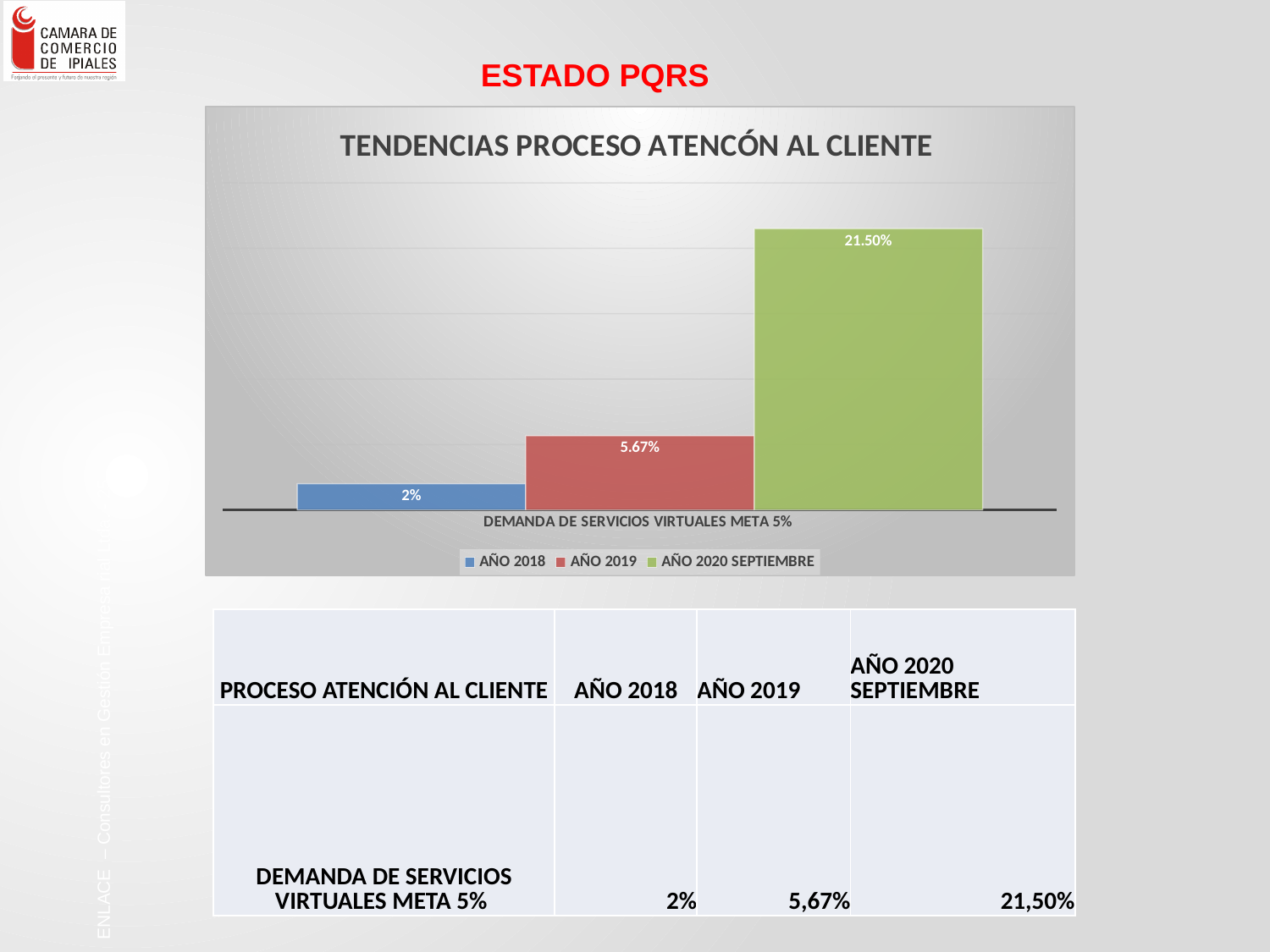
How many categories are shown on the x axis of the chart? 1 Which series has the lowest value in the chart? AÑO 2018 What is the value for AÑO 2018 in the chart? 2% What kind of chart is shown on the slide? Bar chart What is the title of the chart? TENDENCIAS PROCESO ATENCÓN AL CLIENTE What is the value for AÑO 2020 SEPTIEMBRE in the chart? 21.50% Do the values rise or fall from AÑO 2018 to AÑO 2020 SEPTIEMBRE? Rise How many series does the legend list? 3 Which series has the highest value in the chart? AÑO 2020 SEPTIEMBRE Which is larger, the value for AÑO 2019 or the value for AÑO 2018? AÑO 2019 What is the category label shown on the x axis of the chart? DEMANDA DE SERVICIOS VIRTUALES META 5% What is the value for AÑO 2019 in the chart? 5.67%